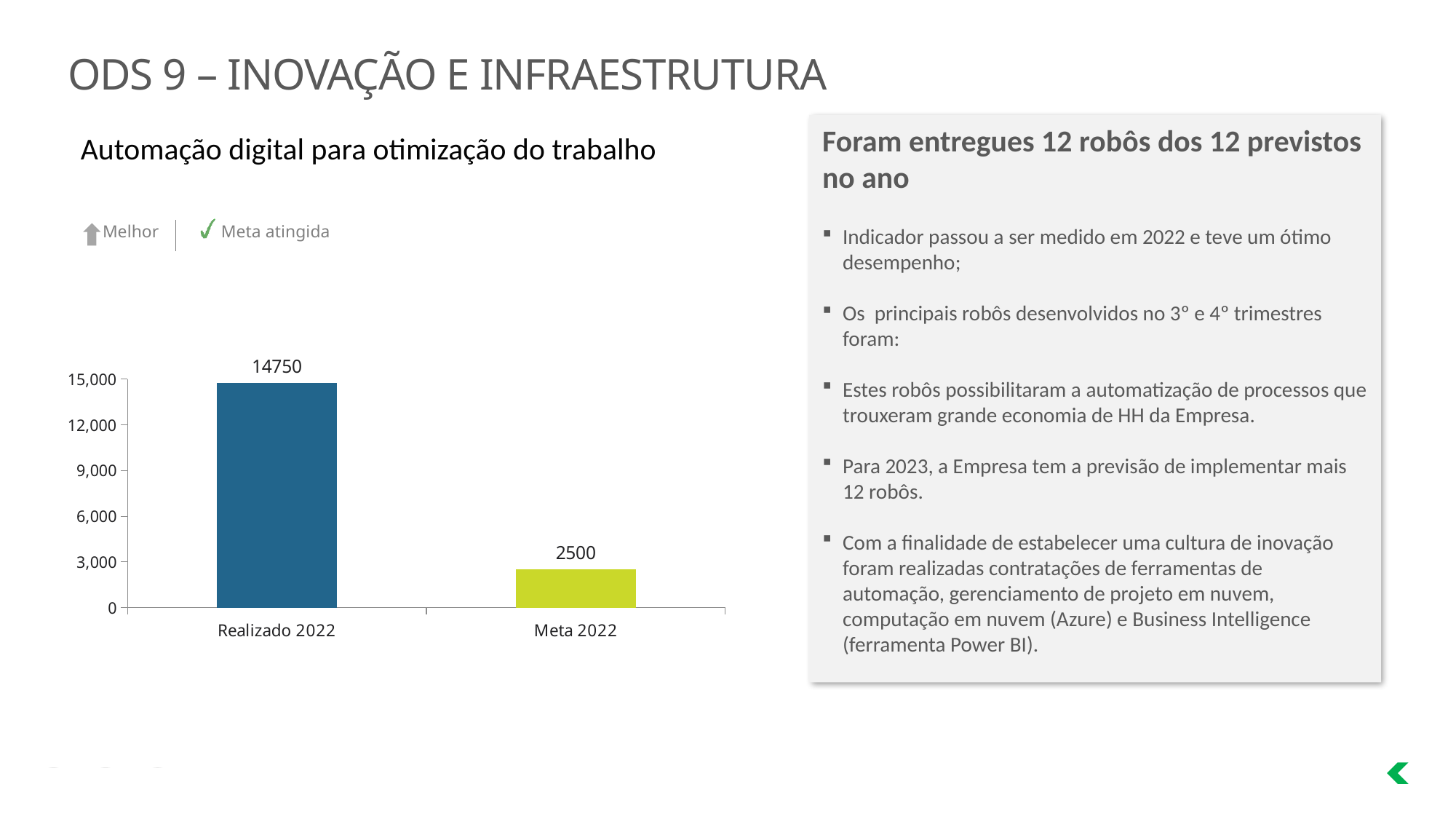
Which category has the highest value? Realizado 2022 Is the value for Meta 2022 greater or less than 3,000? less How many categories are shown on the x axis of the chart? 2 What is the value for Meta 2022? 2500 Is the value for Realizado 2022 greater or less than 12,000? greater Which is larger, the value for Realizado 2022 or the value for Meta 2022? Realizado 2022 What is the value for Realizado 2022? 14750 What kind of chart is shown on the slide? bar chart What is the highest tick value shown on the y axis of the chart? 15,000 What is the difference between the values for Realizado 2022 and Meta 2022? 12250 What is the title of the chart? Automação digital para otimização do trabalho Which category has the lowest value? Meta 2022